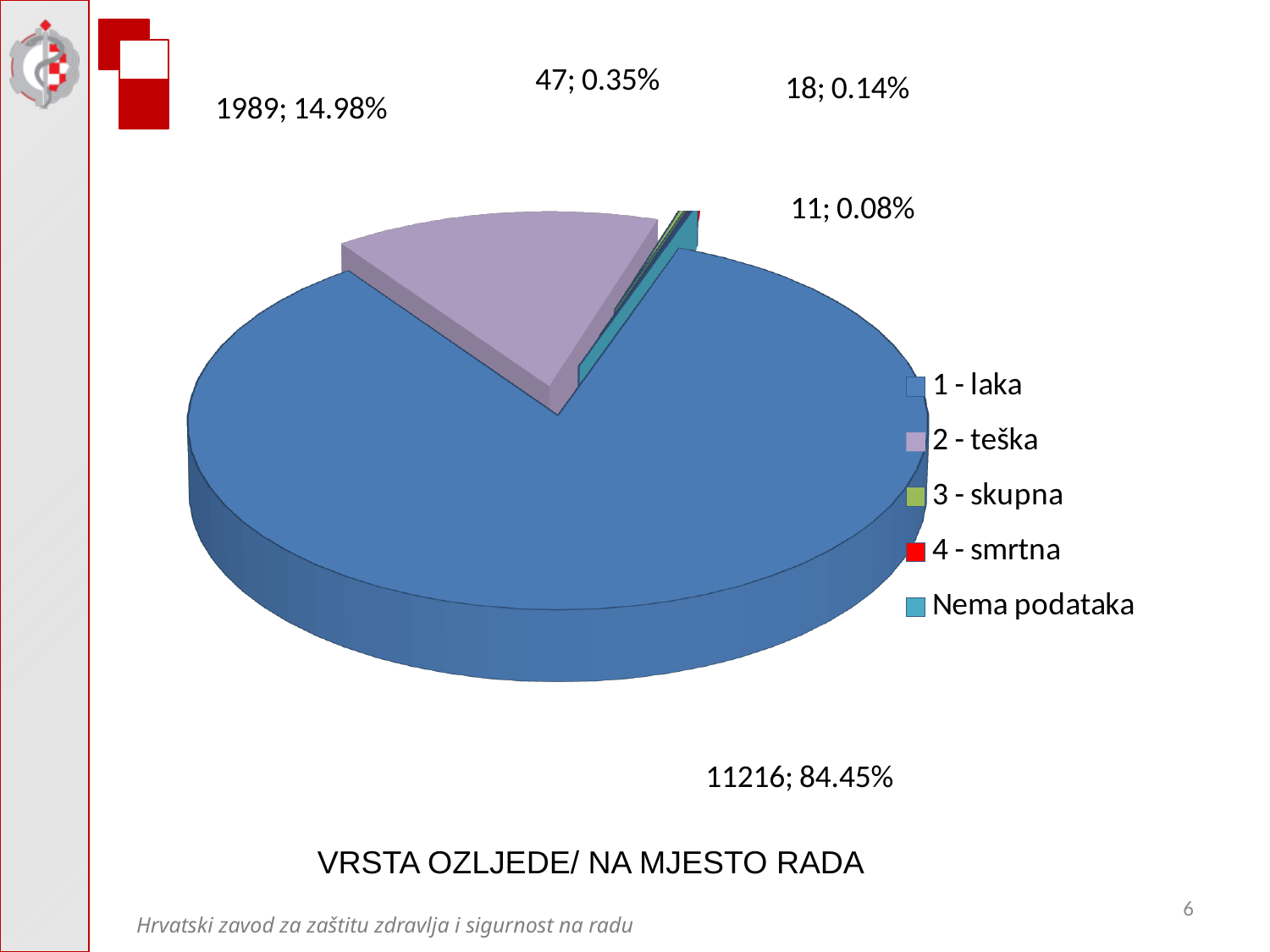
How many categories does the legend of the pie chart list? 5 What share of the pie does '2 - teška' represent? 14.98% Which is larger, the value for '2 - teška' or the value for '3 - skupna'? 2 - teška What type of chart is shown on the slide? pie chart What is the difference between the values for '1 - laka' and '2 - teška'? 9227 Which category has the largest slice of the pie? 1 - laka What value is shown for the category '2 - teška'? 1989 What colour is the slice for '2 - teška'? purple Which category has the smallest slice of the pie? Nema podataka What share of the pie does '1 - laka' represent? 84.45% What is the title of the chart? VRSTA OZLJEDE/ NA MJESTO RADA What value is shown for the category '1 - laka'? 11216